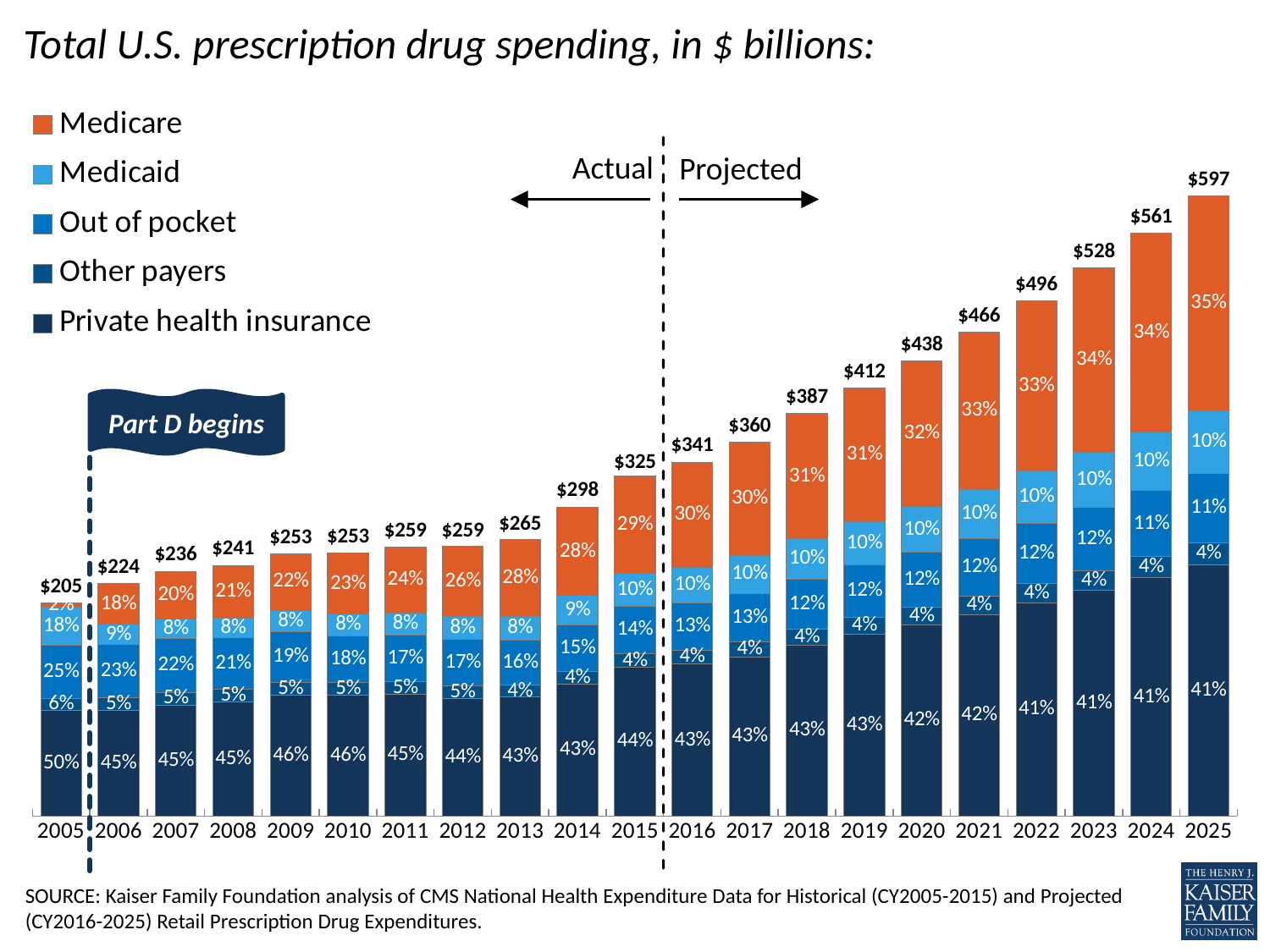
What is the difference between the total spending in 2025 and the total spending in 2005? $392 Which year has the lowest total spending? 2005 What kind of chart is shown on the slide? Stacked bar chart Which year has the highest total spending? 2025 What share of spending is attributed to private health insurance in 2005? 50% What share of spending is attributed to Medicare in 2025? 35% Does total spending rise or fall from 2005 to 2025? Rise What is the total U.S. prescription drug spending shown for 2025? $597 How many years are shown on the x axis? 21 What share of spending is attributed to Medicaid in 2015? 10% How many series does the legend list? 5 What is the total U.S. prescription drug spending shown for 2005? $205